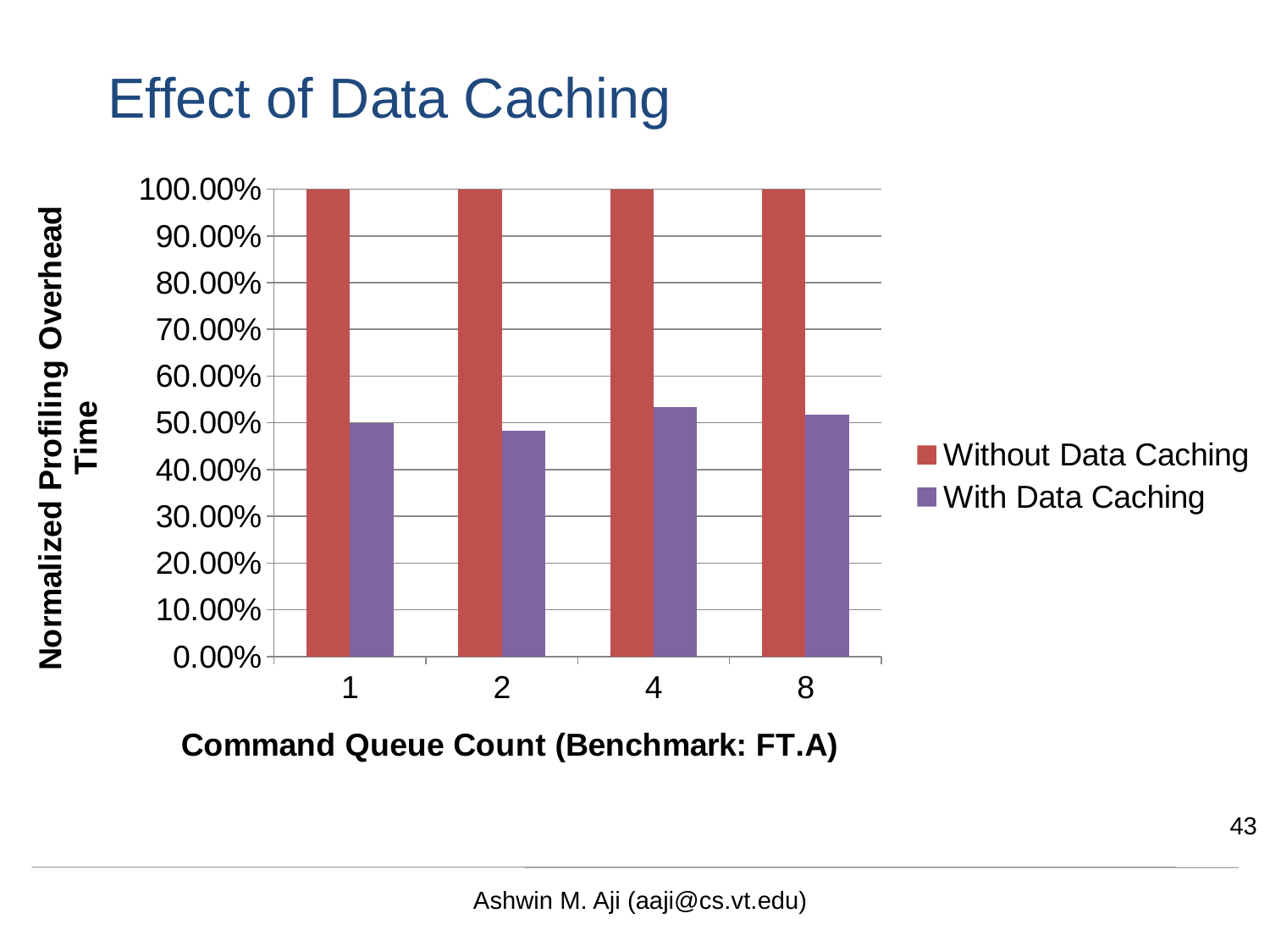
How many command queue count categories are shown on the x axis? 4 What kind of chart is shown on the slide? bar chart How many series does the legend list? 2 What is the Without Data Caching value for command queue count 1? 100.00% What is the Without Data Caching value for command queue count 8? 100.00% Is the With Data Caching value for command queue count 8 greater or less than 70.00%? less Within the With Data Caching series, which is larger: the value for command queue count 2 or for command queue count 4? command queue count 4 For command queue count 4, which series has the larger value, Without Data Caching or With Data Caching? Without Data Caching Which series is drawn in purple? With Data Caching Is the With Data Caching value for command queue count 2 greater or less than 60.00%? less Is the With Data Caching value for command queue count 4 greater or less than 40.00%? greater What is the title of the chart's x axis? Command Queue Count (Benchmark: FT.A)